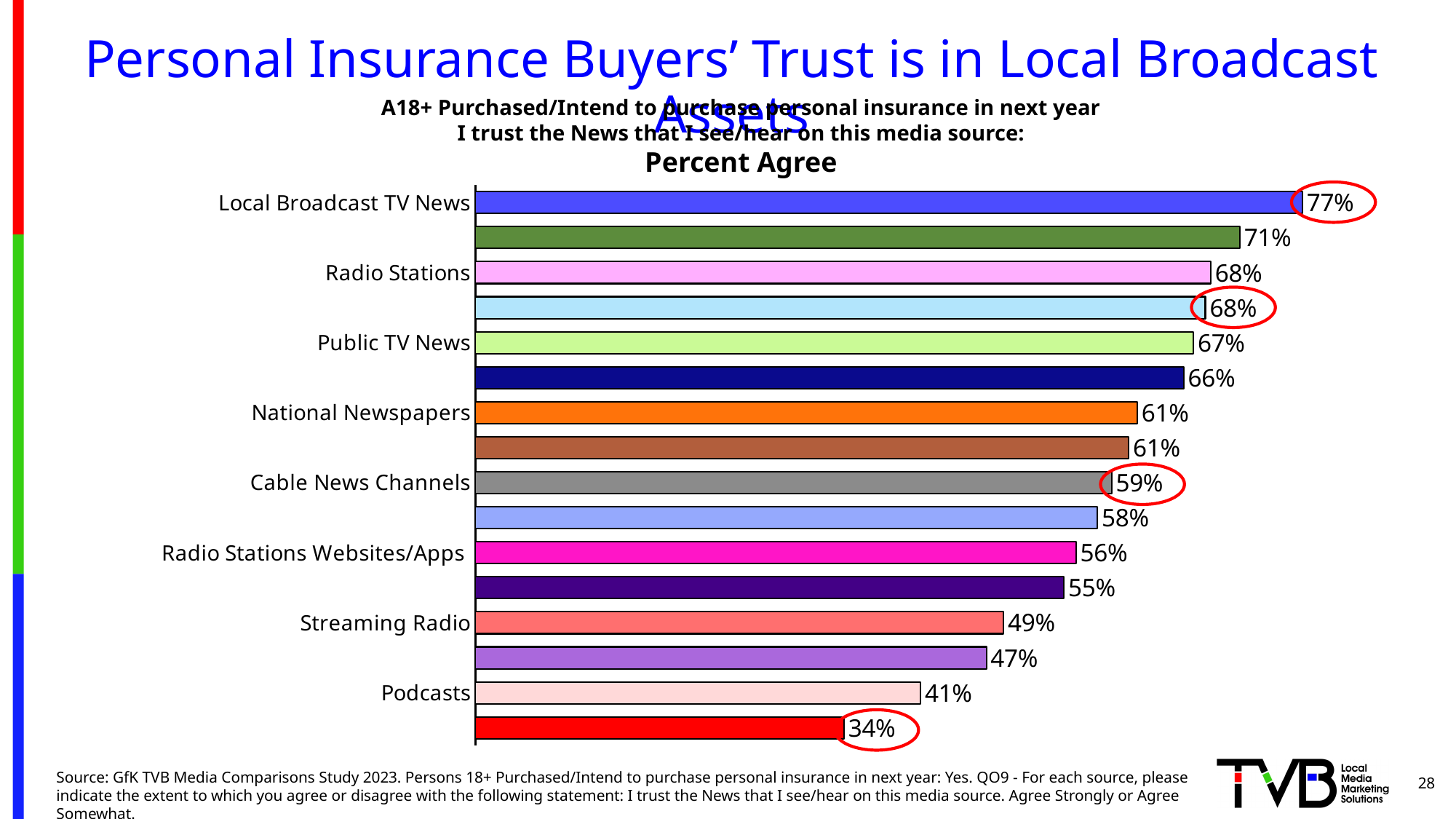
Which media source has the highest percent agree? Local Broadcast TV News What is the lowest percent agree value shown on the chart? 34% How many bars are plotted on the chart? 16 What is the percent agree value for Public TV News? 67% What kind of chart is shown on the slide? Bar chart What is the percent agree value for National Newspapers? 61% Which has a higher percent agree, Streaming Radio or Radio Stations Websites/Apps? Radio Stations Websites/Apps What is the percent agree value for Cable News Channels? 59% How many percentage points higher is Local Broadcast TV News than Podcasts? 36 percentage points What is the percent agree value for Radio Stations? 68% What percentage of personal insurance buyers agree they trust the news on Local Broadcast TV News? 77% What is the percent agree value for Podcasts? 41%